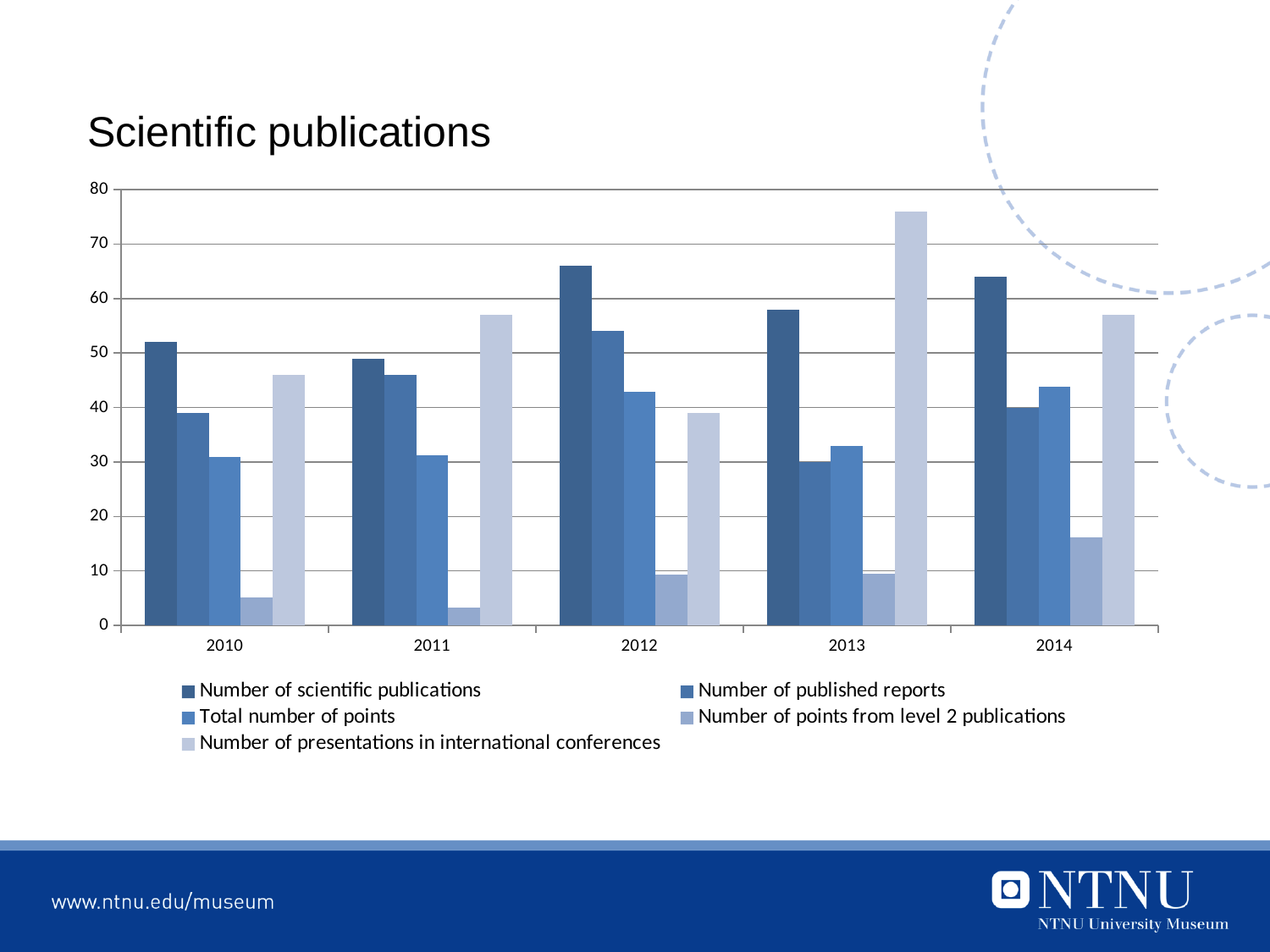
What kind of chart is shown on the slide? bar chart What is the title of the chart? Scientific publications Is the number of points from level 2 publications in 2010 greater or less than 10? less Is the number of published reports in 2011 greater or less than 40? greater In 2013, which is larger: the number of presentations in international conferences or the number of scientific publications? Number of presentations in international conferences Which year has the highest number of presentations in international conferences? 2013 How many years are shown on the x axis? 5 Which year has the lowest number of points from level 2 publications? 2011 Is the number of presentations in international conferences in 2013 greater or less than 70? greater Which year has the highest number of scientific publications? 2012 How many series does the legend list? 5